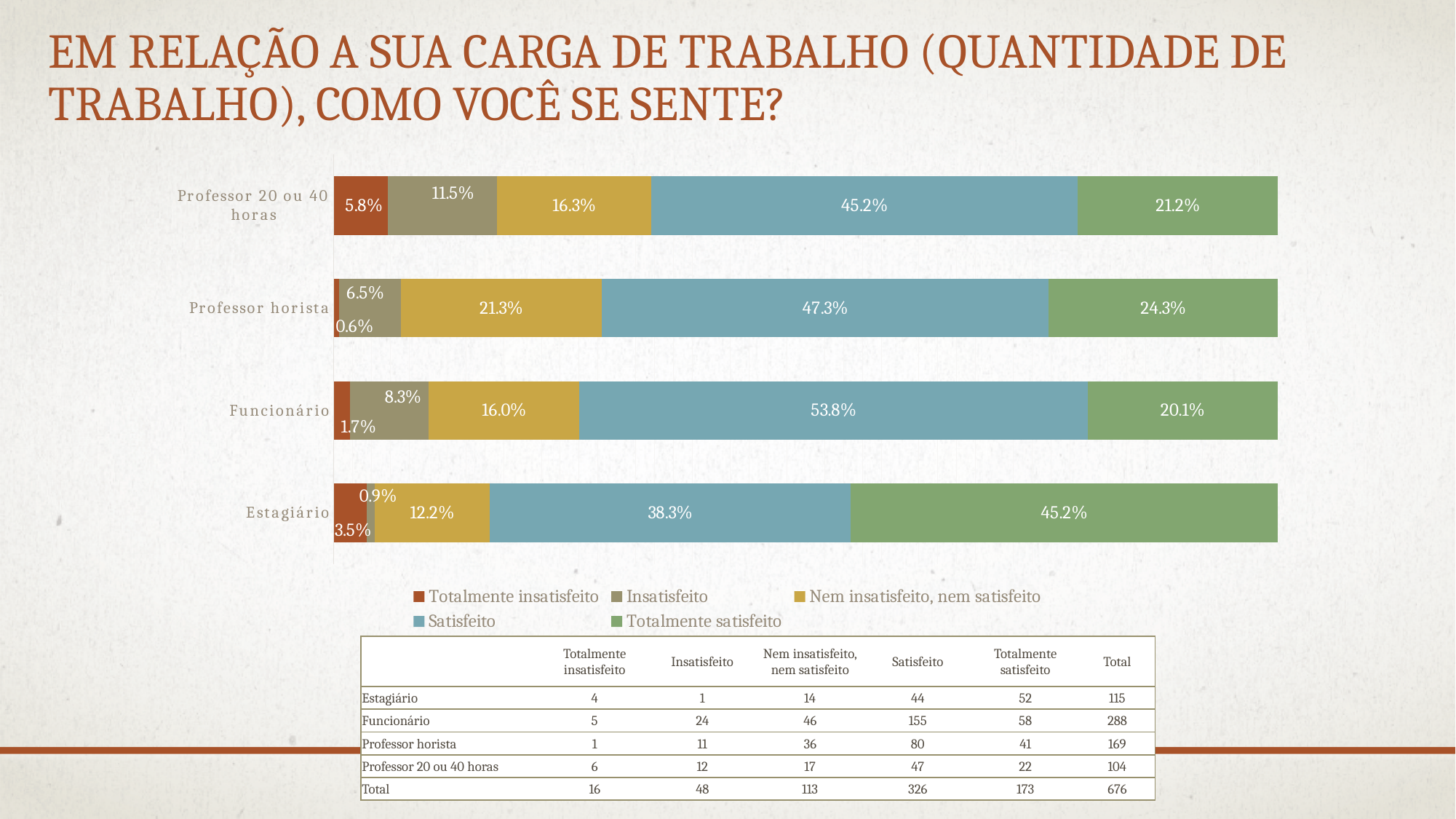
How many categories are shown on the chart? 4 What is the difference in Totalmente satisfeito between Estagiário and Professor 20 ou 40 horas? 24.0 percentage points What is the Totalmente satisfeito value for Estagiário? 45.2% Which category has the highest Totalmente satisfeito percentage? Estagiário What percentage of Funcionário respondents are Satisfeito? 53.8% Which category has the lowest Totalmente insatisfeito percentage? Professor horista How many series does the legend list? 5 Which has a larger Nem insatisfeito, nem satisfeito share: Professor horista or Funcionário? Professor horista Which category has the highest Satisfeito percentage? Funcionário What kind of chart is shown? Stacked bar chart What is the Insatisfeito value for Professor 20 ou 40 horas? 11.5% What colour represents Satisfeito in the legend? Blue